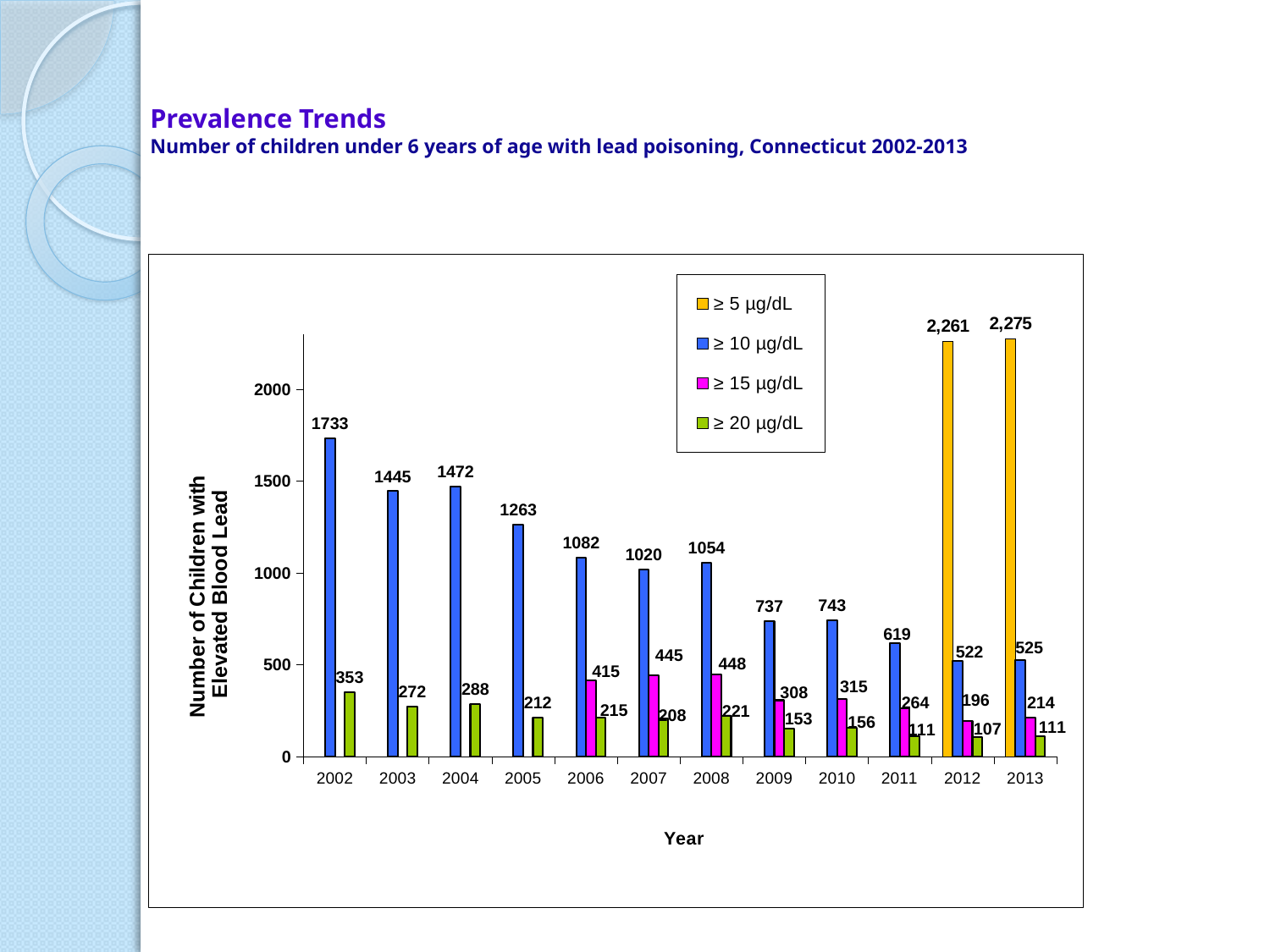
Does the ≥ 10 µg/dL series generally rise or fall from 2002 to 2013? Fall What is the value for the ≥ 10 µg/dL series in 2002? 1733 What kind of chart is shown on the slide? Bar chart What is the difference between the ≥ 10 µg/dL values for 2002 and 2003? 288 What is the value for the ≥ 20 µg/dL series in 2012? 107 What is the value for the ≥ 15 µg/dL series in 2008? 448 How many years are shown on the x axis? 12 In which year is the ≥ 10 µg/dL series highest? 2002 What is the value for the ≥ 5 µg/dL series in 2013? 2,275 In which year is the ≥ 20 µg/dL series lowest? 2012 How many series does the legend list? 4 Which is larger, the ≥ 15 µg/dL value for 2007 or for 2006? 2007